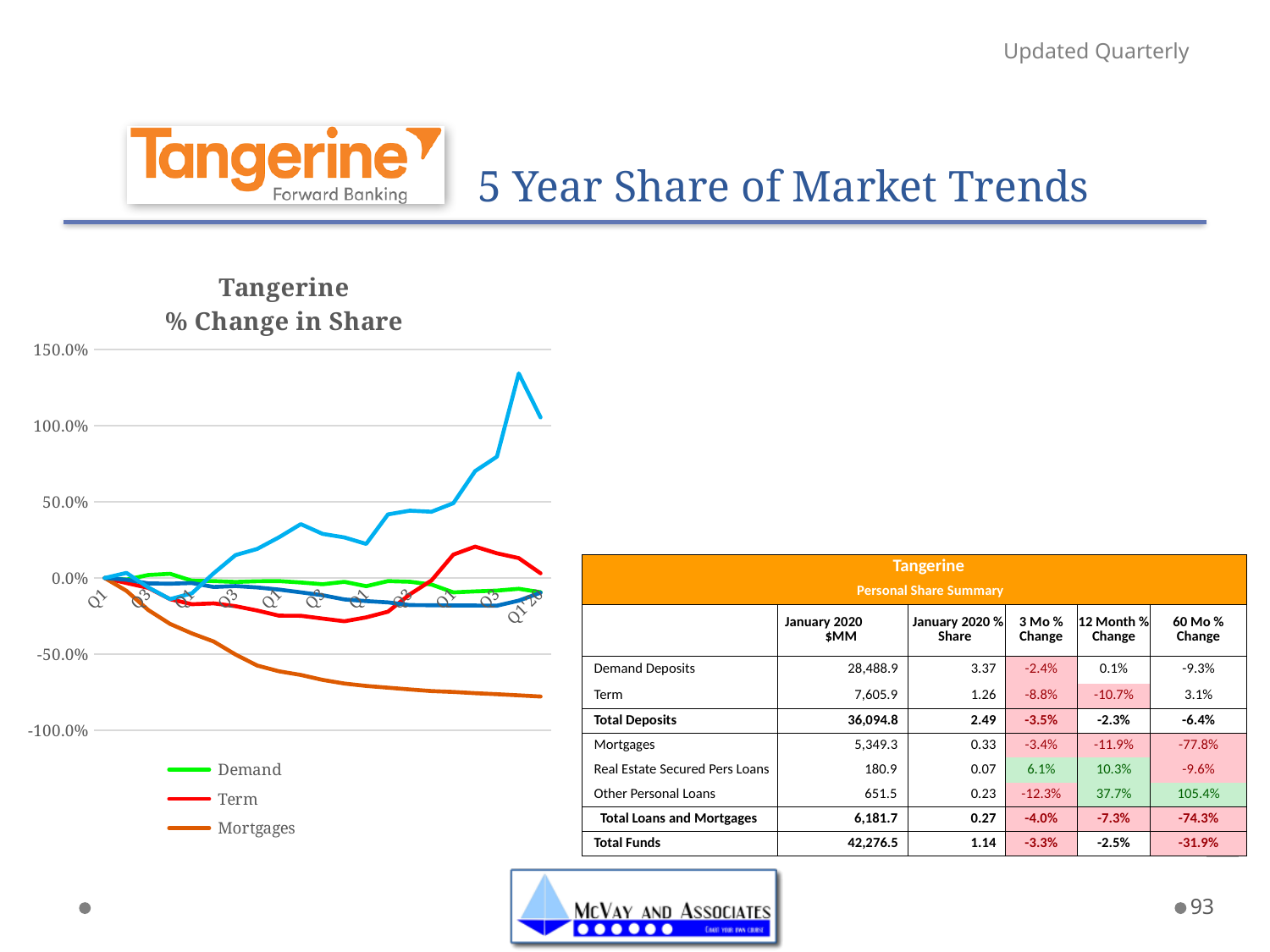
What is the highest value shown on the chart's vertical axis? 150.0% Which of the legend series ends the period at the lowest value? Mortgages At the end of the period, which is higher: the Term line or the Mortgages line? Term Is the final value of the Mortgages line greater or less than -50.0%? less Which colour is used for the Mortgages line in the chart? Orange What is the title of the chart? Tangerine % Change in Share What kind of chart is shown on the slide? Line chart Does the Mortgages line rise or fall over the period shown on the x axis? Fall Is the final value of the Term line greater or less than -50.0%? greater How many series does the chart legend list? 3